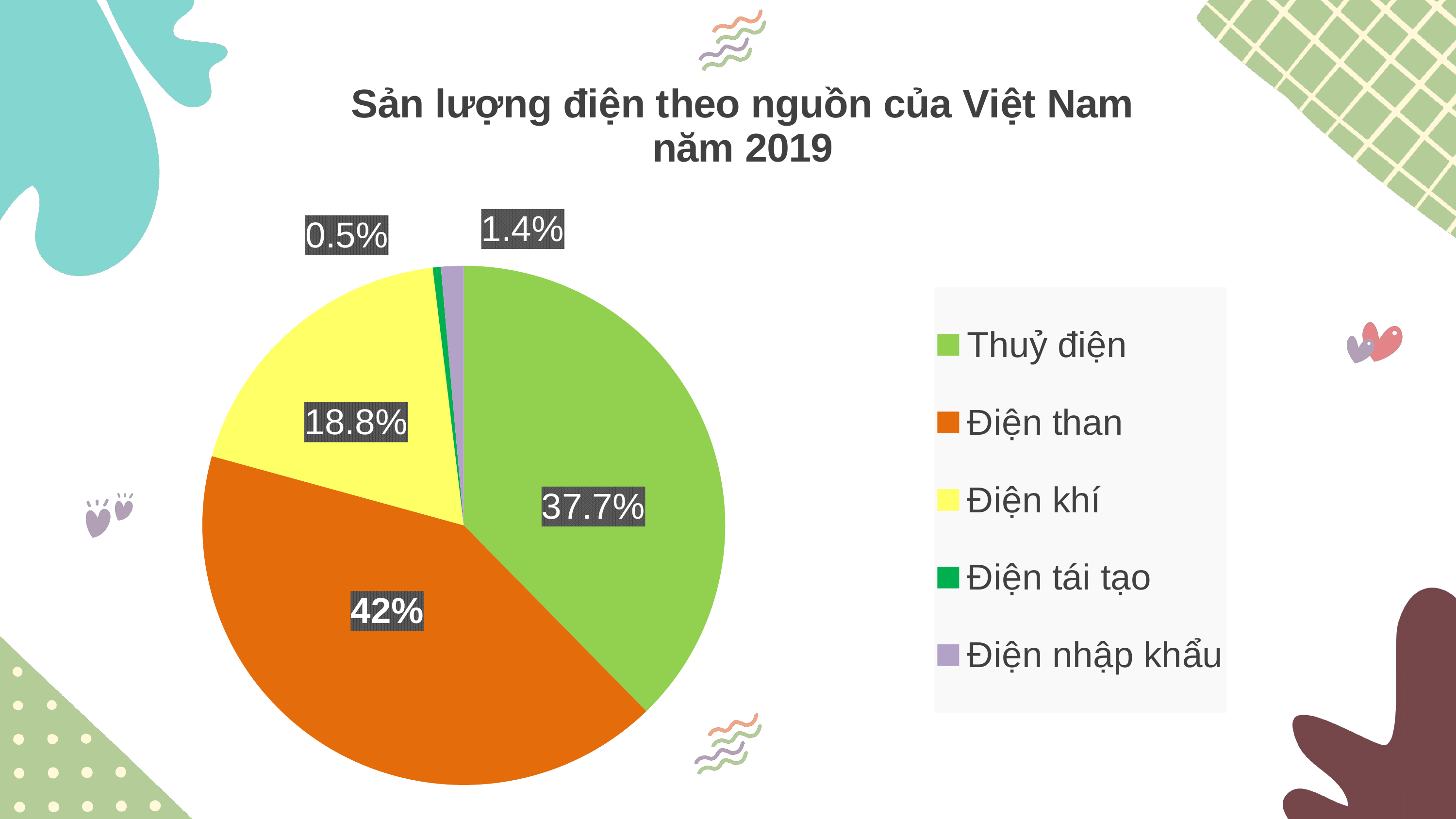
What share of the pie does Thuỷ điện have? 37.7% What share of the pie does Điện khí have? 18.8% What share of the pie does Điện than have? 42% What is the title of the chart? Sản lượng điện theo nguồn của Việt Nam năm 2019 Which source has the largest share of the pie? Điện than How many categories does the legend list? 5 Which is larger, the share of Điện khí or the share of Điện nhập khẩu? Điện khí What share of the pie does Điện tái tạo have? 0.5% What share of the pie does Điện nhập khẩu have? 1.4% Which source has the smallest share of the pie? Điện tái tạo What kind of chart is shown on the slide? pie chart What is the difference between the shares of Điện than and Thuỷ điện? 4.3%